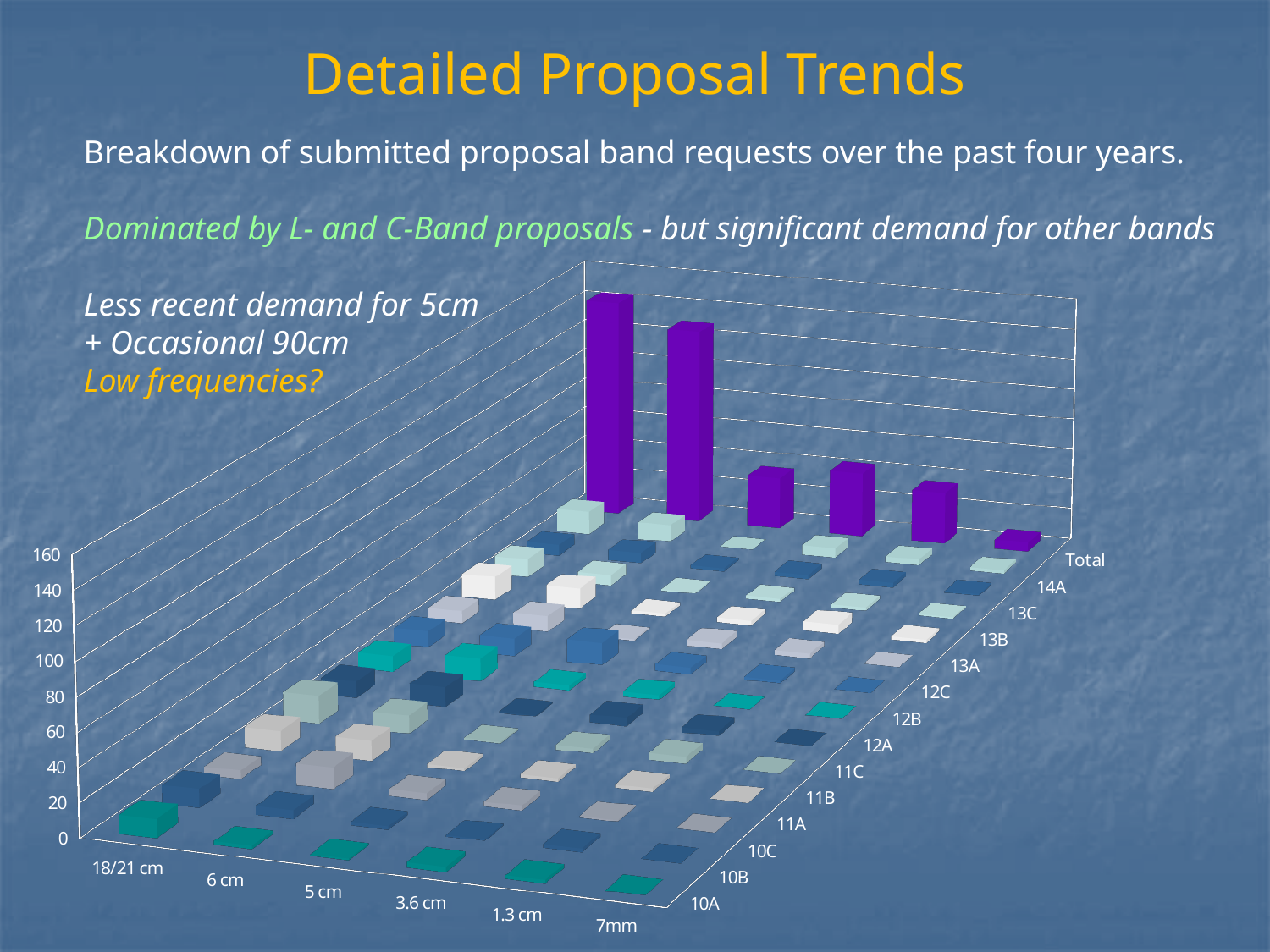
In the Total series, which wavelength band has the highest bar? 18/21 cm Is the Total value for 6 cm greater or less than 80? greater What is the maximum value shown on the vertical axis of the chart? 160 In the Total series, which wavelength band has the lowest bar? 7mm Is the Total value for 18/21 cm greater or less than 100? greater What kind of chart is shown on the slide? bar chart How many wavelength bands are listed along the front axis of the chart? 6 In the Total series, which is larger: the bar for 18/21 cm or the bar for 6 cm? 18/21 cm What is the title of the slide containing the chart? Detailed Proposal Trends How many semester/series labels (10A through Total) are listed along the depth axis of the chart? 14 Do the Total bars generally rise or fall moving from 18/21 cm to 7mm along the front axis? fall Is the Total value for 7mm greater or less than 20? less